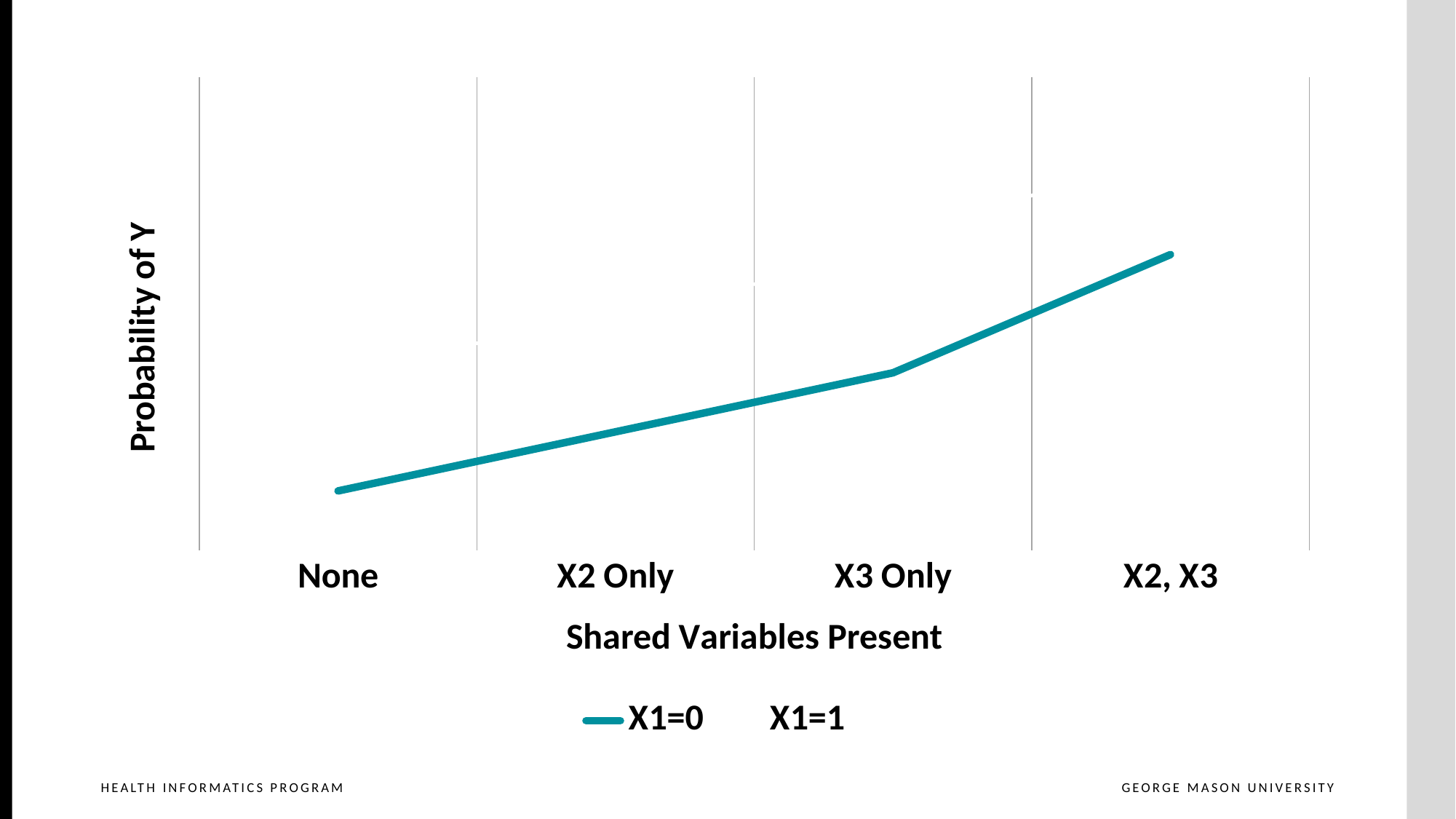
Which category has the highest value for the X1=0 line? X2, X3 For the X1=0 line, is the value for X3 Only larger or smaller than the value for X2 Only? larger Do the values of the X1=0 line rise or fall from None to X2, X3? rise What is the title of the x axis? Shared Variables Present What kind of chart is shown on the slide? line chart What is the title of the y axis? Probability of Y For the X1=0 line, which is larger: the value for None or the value for X2, X3? X2, X3 How many series does the legend list? 2 How many categories are shown on the x axis? 4 Which category has the lowest value for the X1=0 line? None